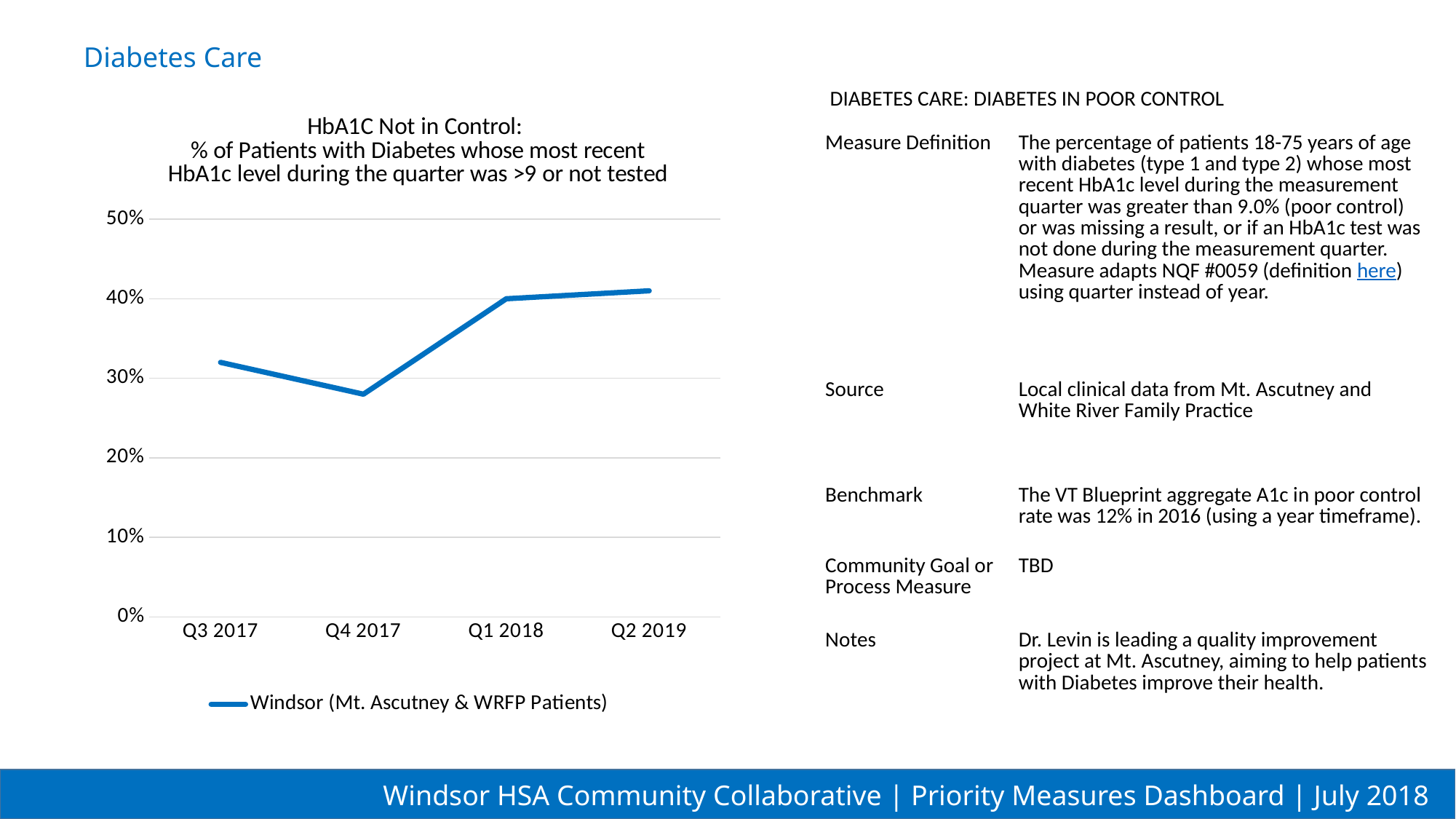
How many series does the chart's legend list? 1 Which is larger, the value for Q1 2018 or the value for Q4 2017? Q1 2018 Is the value for Q2 2019 greater or less than 30%? greater What is the series name shown in the chart's legend? Windsor (Mt. Ascutney & WRFP Patients) What kind of chart is shown on the slide? line chart Does the value rise or fall from Q4 2017 to Q1 2018? rise How many quarters are plotted on the x axis of the chart? 4 Is the value for Q3 2017 greater or less than 30%? greater Which quarter has the lowest value in the chart? Q4 2017 Is the value for Q4 2017 greater or less than 30%? less Which is larger, the value for Q3 2017 or the value for Q4 2017? Q3 2017